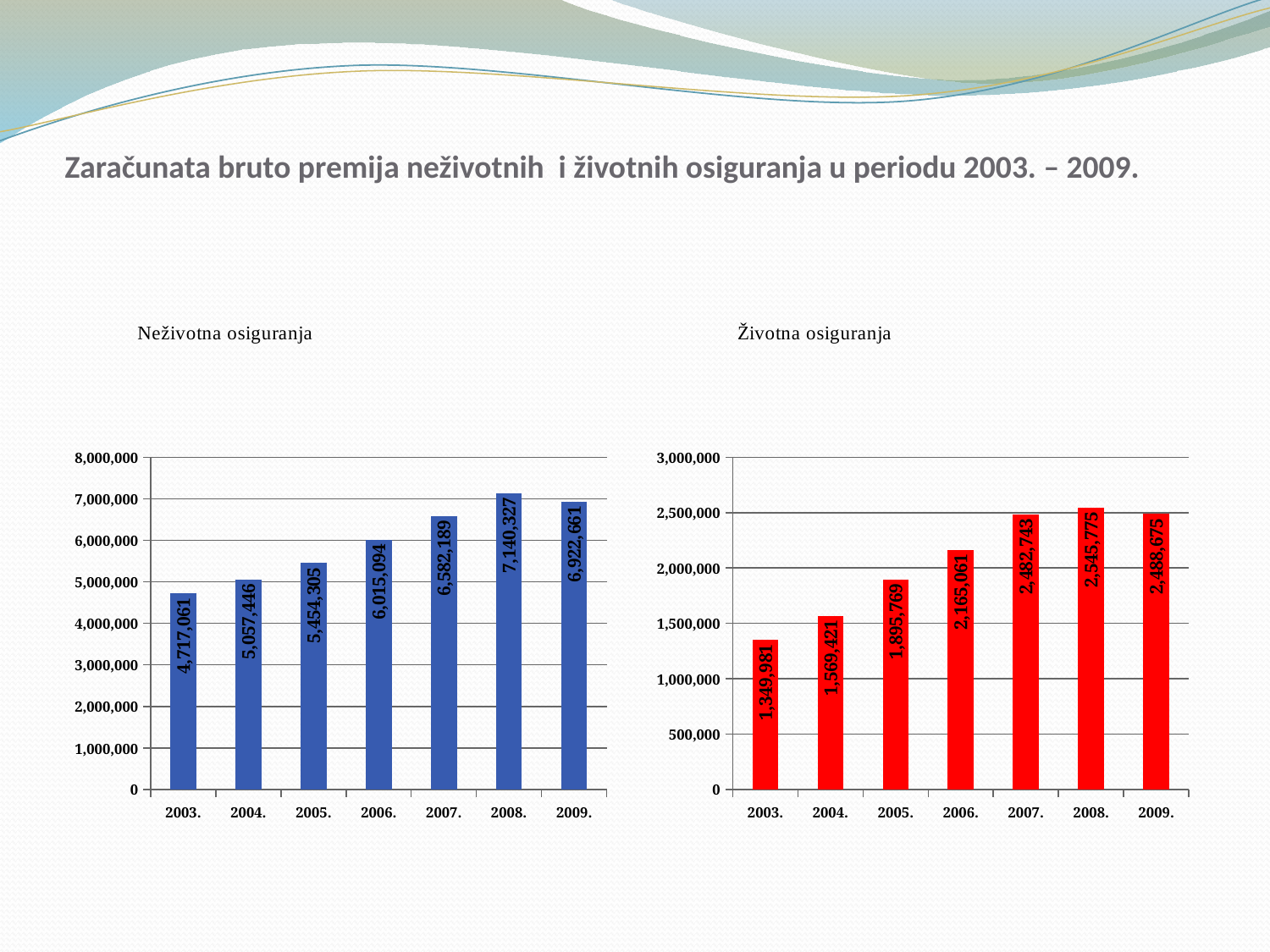
In the Životna osiguranja chart, what is the value for 2006.? 2,165,061 In the Neživotna osiguranja chart, which year has the highest value? 2008. In the Životna osiguranja chart, do the values rise or fall from 2003. to 2008.? rise How many years are shown in the Neživotna osiguranja chart? 7 In the Životna osiguranja chart, which year has the lowest value? 2003. In the Neživotna osiguranja chart, which is larger, the value for 2006. or the value for 2007.? 2007. What colour are the bars in the Neživotna osiguranja chart? blue In the Neživotna osiguranja chart, what is the value for 2003.? 4,717,061 What kind of chart is the Životna osiguranja chart? bar chart In the Životna osiguranja chart, is the value for 2005. greater or less than 2,000,000? less In the Životna osiguranja chart, what is the difference between the values for 2004. and 2003.? 219,440 In the Neživotna osiguranja chart, what is the difference between the values for 2008. and 2009.? 217,666